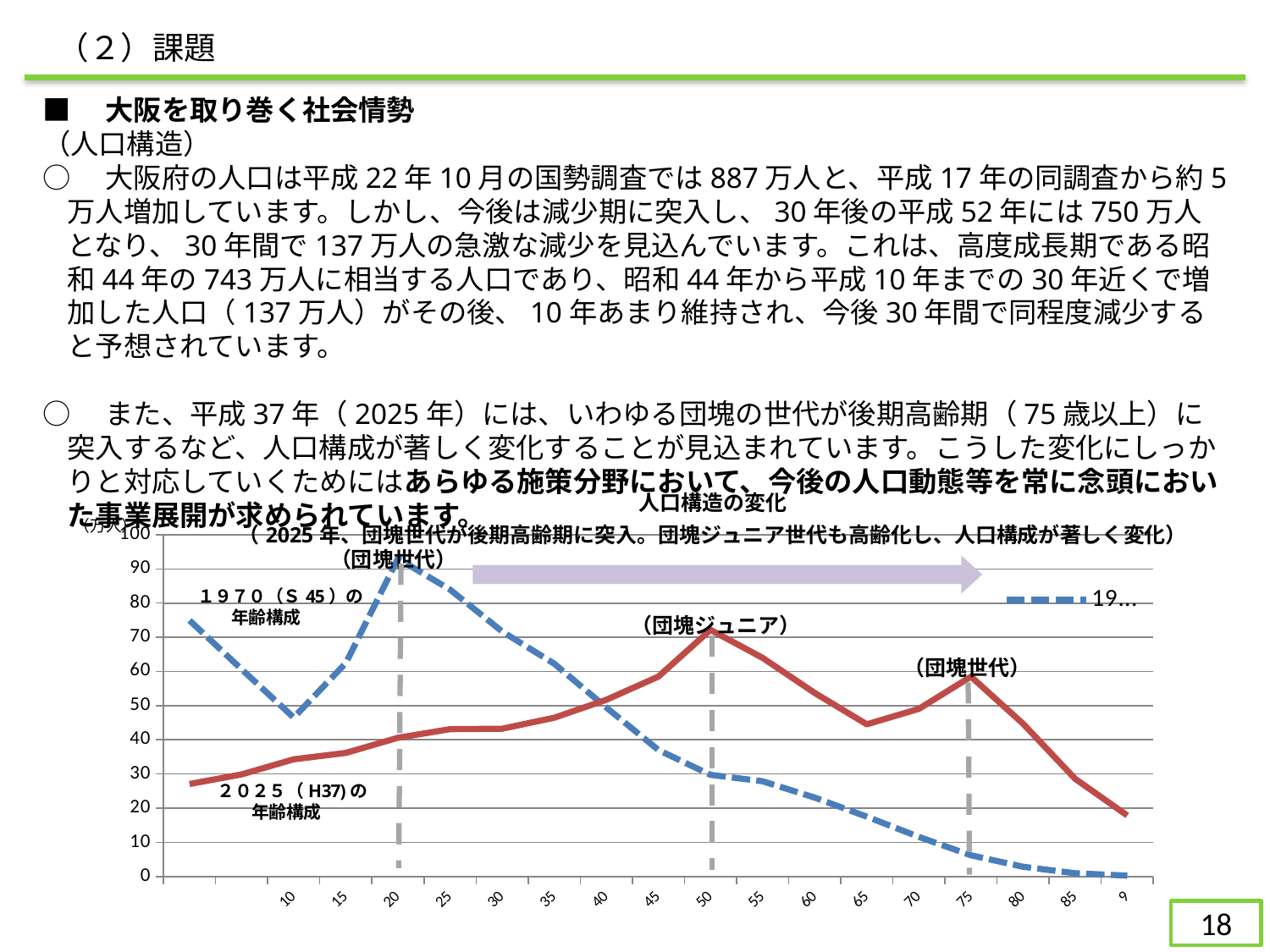
Is the value of the 2025 (H37) series at age 50 greater or less than 60? greater At age 50, which series has the higher value, 1970 (S45) or 2025 (H37)? 2025 (H37) Is the value of the 1970 (S45) series at age 85 greater or less than 10? less How many lines (series) are plotted on the chart? 2 Which series is drawn as a dashed line, the 1970 (S45) age composition or the 2025 (H37) age composition? 1970 (S45) Is the value of the 1970 (S45) series at age 20 greater or less than 80? greater At age 20, which series has the higher value, 1970 (S45) or 2025 (H37)? 1970 (S45) What kind of chart is shown on the slide? line chart At which age group does the 2025 (H37) series reach its highest value? 50 What is the title of the chart? 人口構造の変化